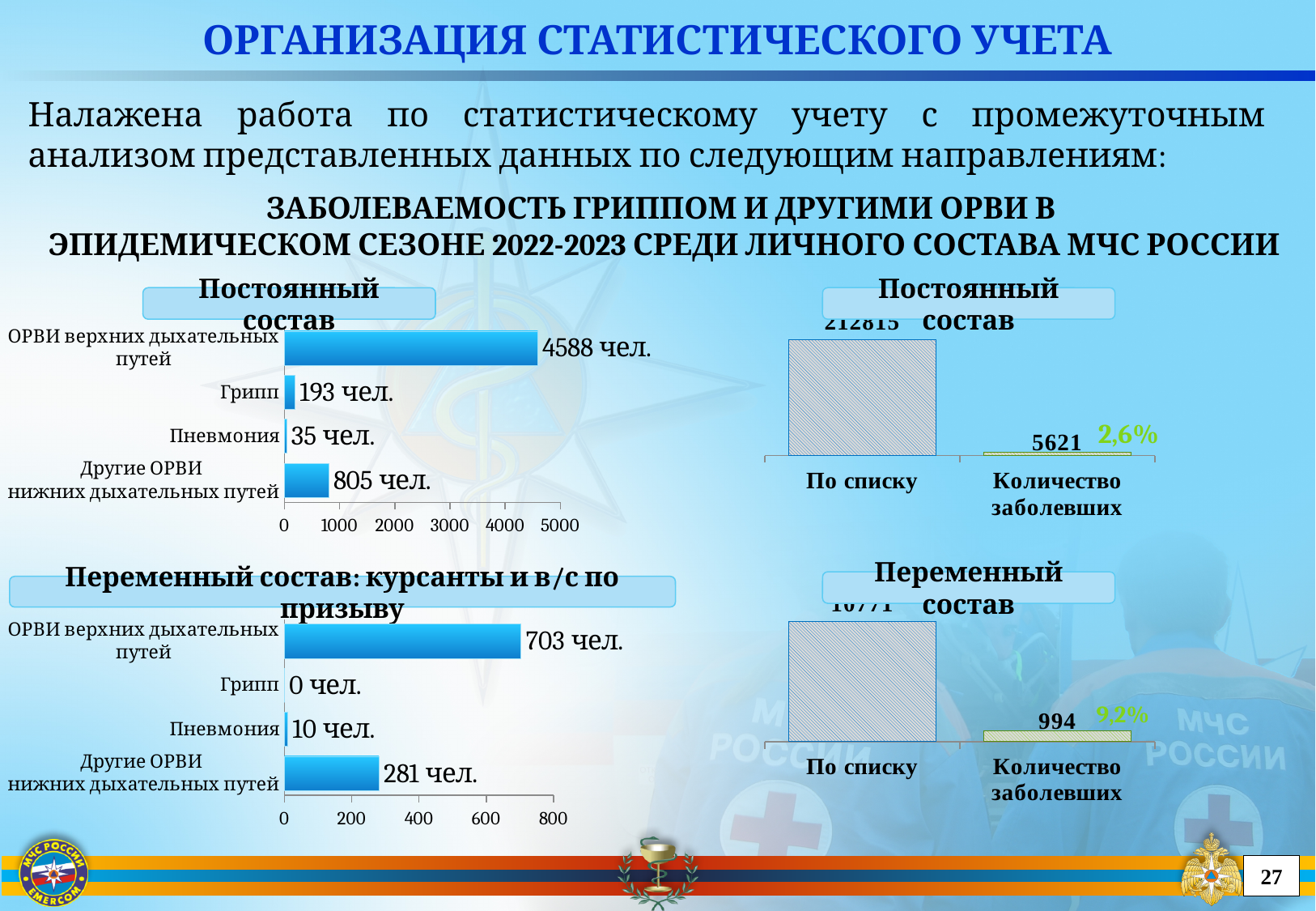
In the top-right chart (Постоянный состав), what is the value for Количество заболевших? 5621 In the bottom-left chart (Переменный состав: курсанты и в/с по призыву), how many categories are shown? 4 In the bottom-left chart (Переменный состав: курсанты и в/с по призыву), what is the value for Грипп? 0 чел. In the bottom-right chart (Переменный состав), what percentage is shown next to the Количество заболевших bar? 9,2% In the top-left chart (Постоянный состав), what is the difference between ОРВИ верхних дыхательных путей and Другие ОРВИ нижних дыхательных путей? 3783 чел. What type of chart is the top-left chart (Постоянный состав)? Bar chart In the bottom-right chart (Переменный состав), what is the value for Количество заболевших? 994 In the top-left chart (Постоянный состав), what is the value for Грипп? 193 чел. In the top-left chart (Постоянный состав), which category has the lowest value? Пневмония In the bottom-left chart (Переменный состав: курсанты и в/с по призыву), which category has the highest value? ОРВИ верхних дыхательных путей In the bottom-left chart (Переменный состав: курсанты и в/с по призыву), what is the value for Другие ОРВИ нижних дыхательных путей? 281 чел. In the top-left chart (Постоянный состав), what is the value for ОРВИ верхних дыхательных путей? 4588 чел.